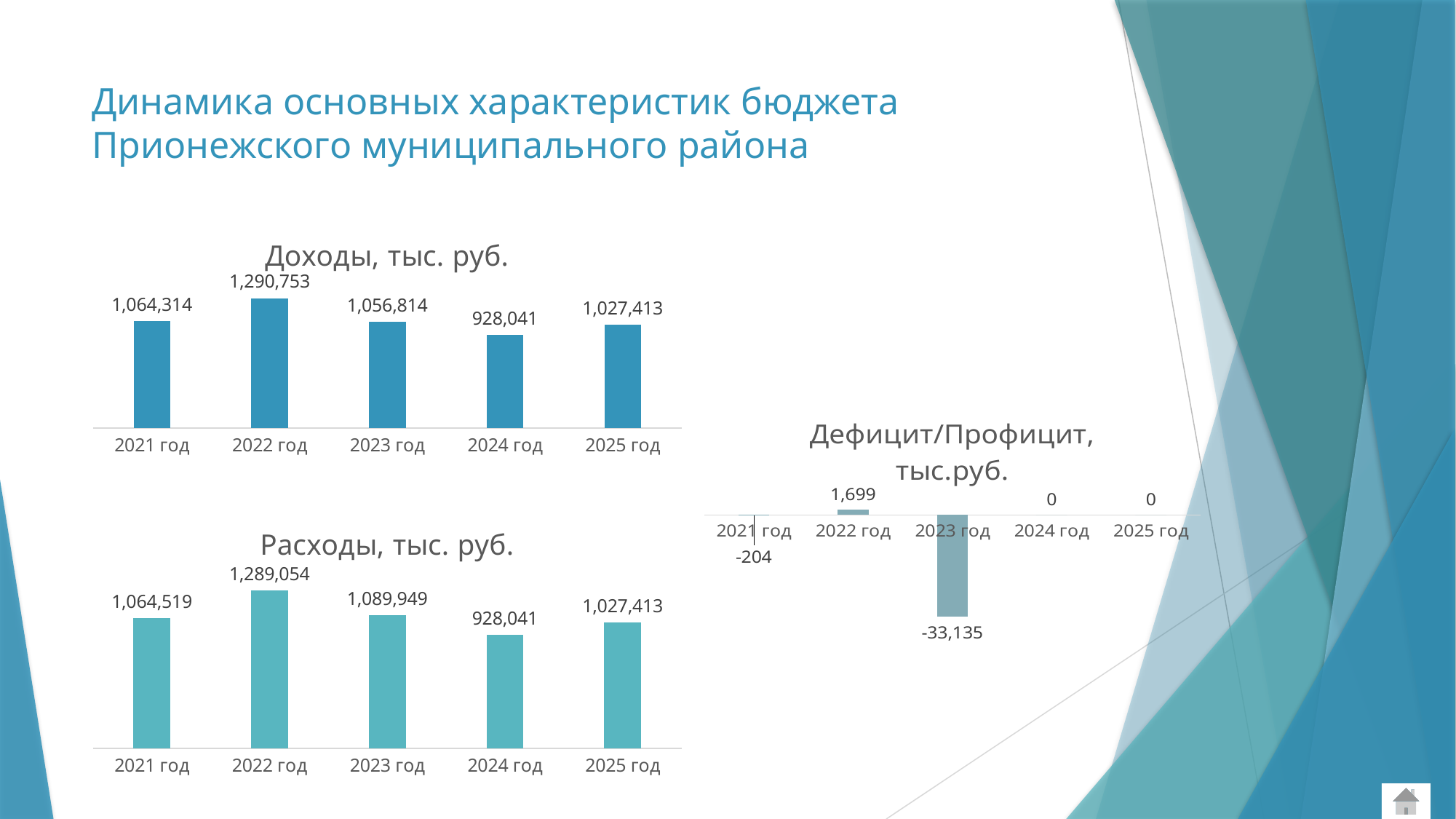
In the 'Дефицит/Профицит, тыс.руб.' chart, what is the value for 2023 год? -33,135 In the 'Расходы, тыс. руб.' chart, what is the value for 2023 год? 1,089,949 Which is larger: the 'Расходы' value for 2023 год or the 'Доходы' value for 2023 год? Расходы (1,089,949) In the 'Расходы, тыс. руб.' chart, how many years are shown? 5 In the 'Доходы, тыс. руб.' chart, which year has the lowest value? 2024 год In the 'Дефицит/Профицит, тыс.руб.' chart, what is the value for 2021 год? -204 In the 'Расходы, тыс. руб.' chart, which year has the highest value? 2022 год In the 'Дефицит/Профицит, тыс.руб.' chart, which year has the highest value? 2022 год How many charts are on the slide? 3 In the 'Доходы, тыс. руб.' chart, what is the difference between the values for 2022 год and 2021 год? 226,439 In the 'Доходы, тыс. руб.' chart, what is the value for 2022 год? 1,290,753 What type of chart is the 'Доходы, тыс. руб.' chart? Bar chart